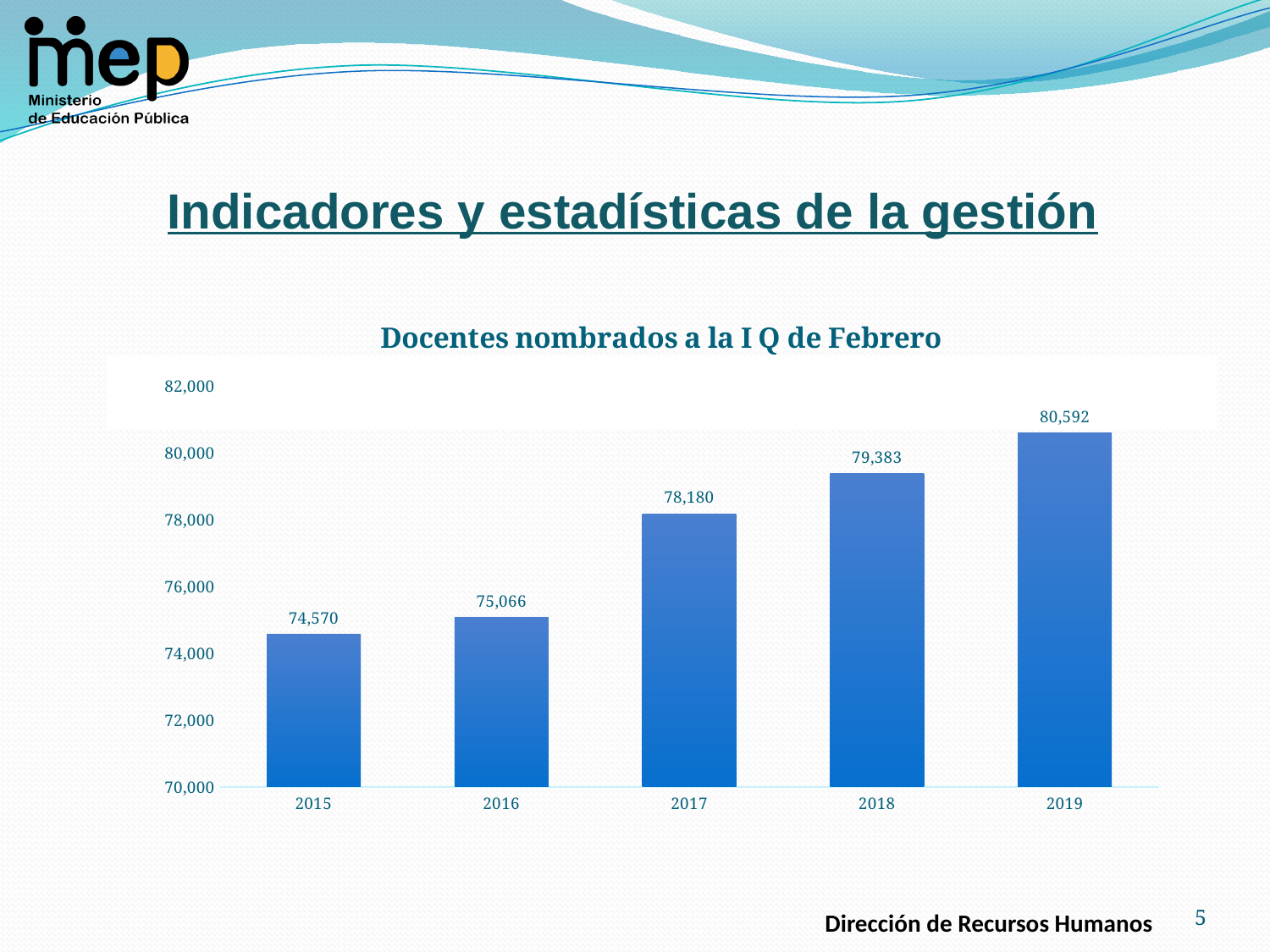
Which year has the highest value? 2019 Which is larger, the value for 2016 or the value for 2018? 2018 Which year has the lowest value? 2015 How many years are shown on the x axis? 5 Is the value for 2018 greater or less than 80,000? less What is the difference between the values for 2019 and 2015? 6,022 What is the value for 2017? 78,180 What is the value for 2015? 74,570 What is the difference between the values for 2018 and 2017? 1,203 What is the value for 2019? 80,592 Do the values rise or fall from 2015 to 2019? rise What kind of chart is this? bar chart